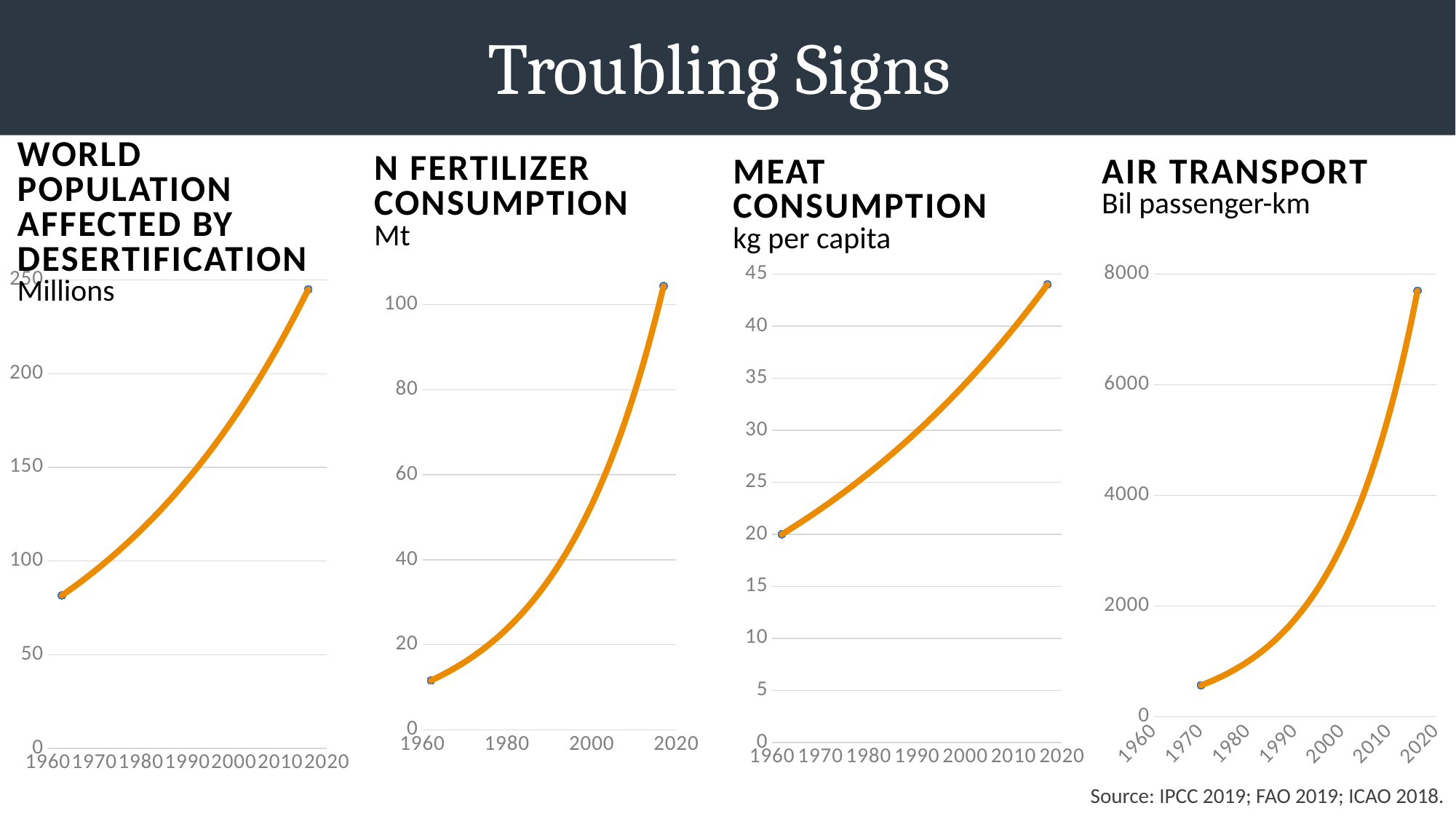
In the WORLD POPULATION AFFECTED BY DESERTIFICATION chart, do the values rise or fall from 1960 to 2020? rise In the MEAT CONSUMPTION chart, do the values rise or fall along the x axis? rise In the MEAT CONSUMPTION chart, is the value at the end of the line (around 2020) greater or less than 40? greater In the N FERTILIZER CONSUMPTION chart, is the value at the start of the line (around 1960) greater or less than 20? less In the N FERTILIZER CONSUMPTION chart, is the value at the end of the line (around 2020) greater or less than 100? greater What unit is shown under the AIR TRANSPORT chart title? Bil passenger-km How many charts are shown on the slide? 4 What kind of chart is the N FERTILIZER CONSUMPTION chart? line chart